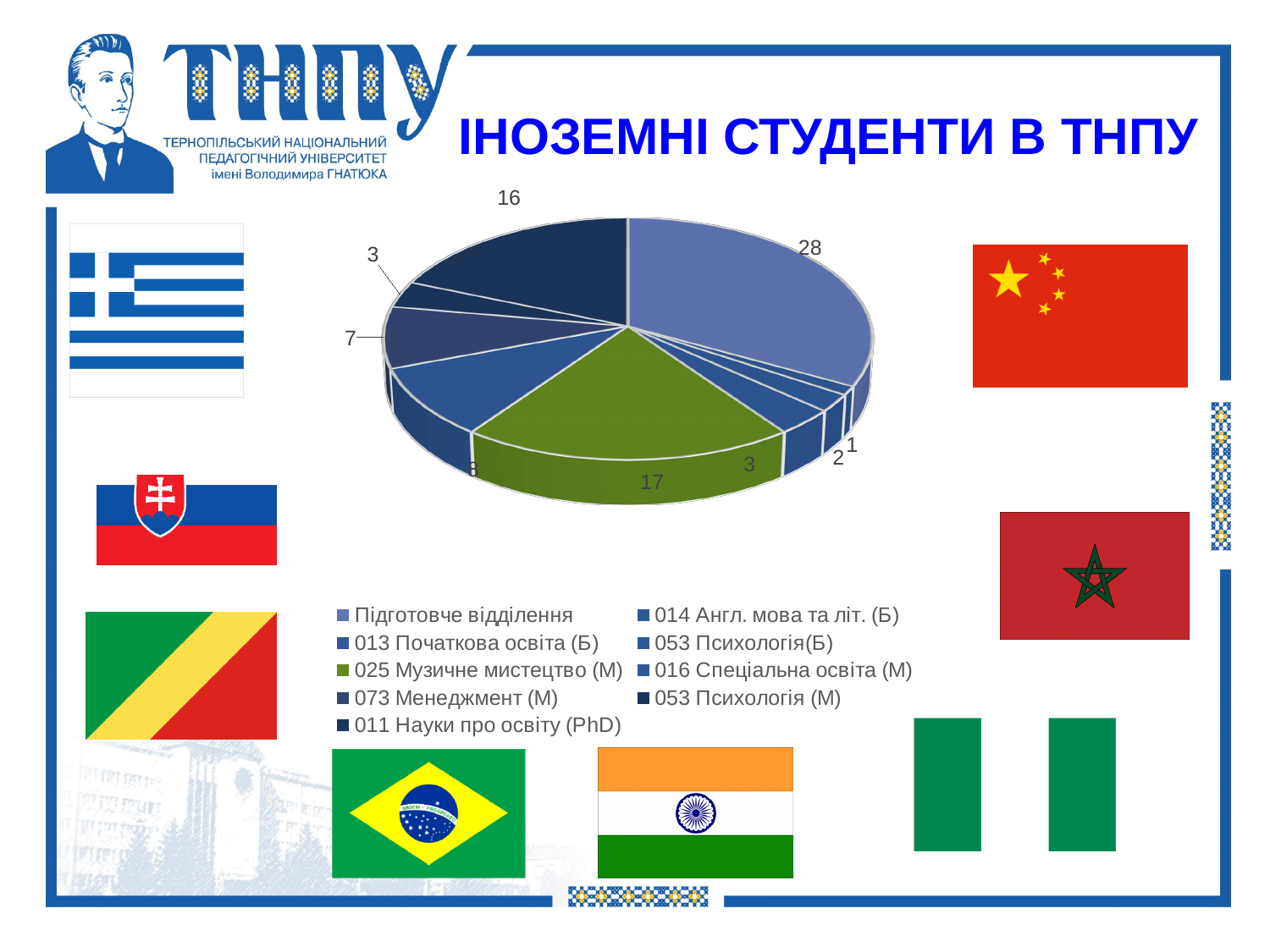
What is the title of the slide containing the chart? ІНОЗЕМНІ СТУДЕНТИ В ТНПУ How many entries does the chart legend list? 9 What is the total of all the slice values shown on the pie chart? 85 What is the value of the largest slice in the pie chart? 28 What is the value for 011 Науки про освіту (PhD), the dark navy slice? 16 How many slices does the pie chart have? 9 What is the value of the green slice (025 Музичне мистецтво (М))? 17 Which category has the largest slice in the pie chart? Підготовче відділення What kind of chart is shown on the slide? pie chart Which is larger: the slice for 025 Музичне мистецтво (М) or the slice for 011 Науки про освіту (PhD)? 025 Музичне мистецтво (М) What is the difference between the largest slice (28) and the green slice (17)? 11 What is the value of the smallest slice in the pie chart? 1